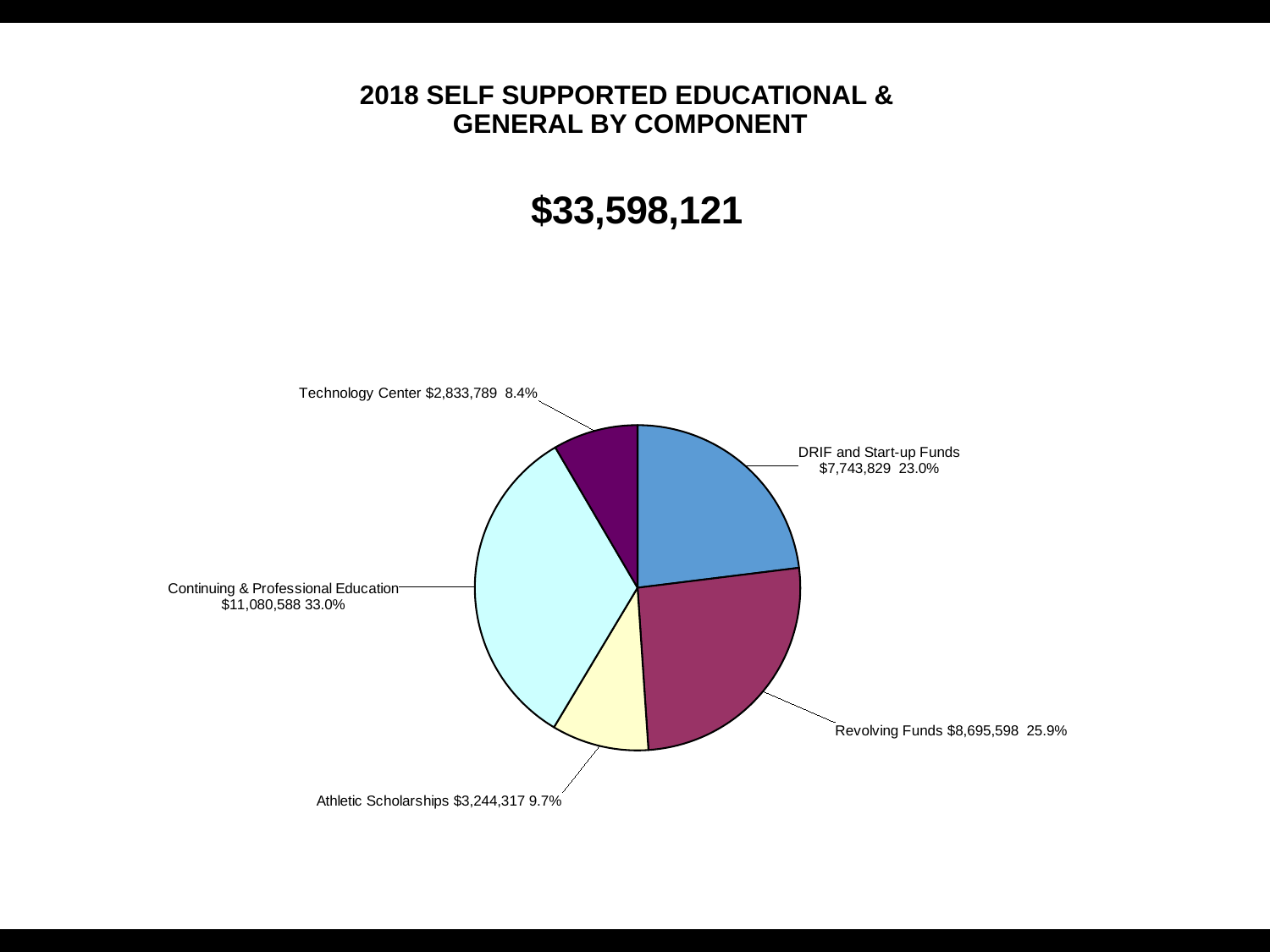
What is the dollar value for Continuing & Professional Education? $11,080,588 What kind of chart is shown on the slide? pie chart What total amount is shown below the chart title? $33,598,121 What percentage share does Technology Center have? 8.4% Which component has the smallest share of the pie? Technology Center How many components are shown in the pie chart? 5 What is the difference in dollars between Revolving Funds and DRIF and Start-up Funds? $951,769 Which component has the largest share of the pie? Continuing & Professional Education What percentage share does DRIF and Start-up Funds have? 23.0% What is the title of the chart? 2018 SELF SUPPORTED EDUCATIONAL & GENERAL BY COMPONENT Which is larger, Athletic Scholarships or Technology Center? Athletic Scholarships What is the dollar value for Revolving Funds? $8,695,598